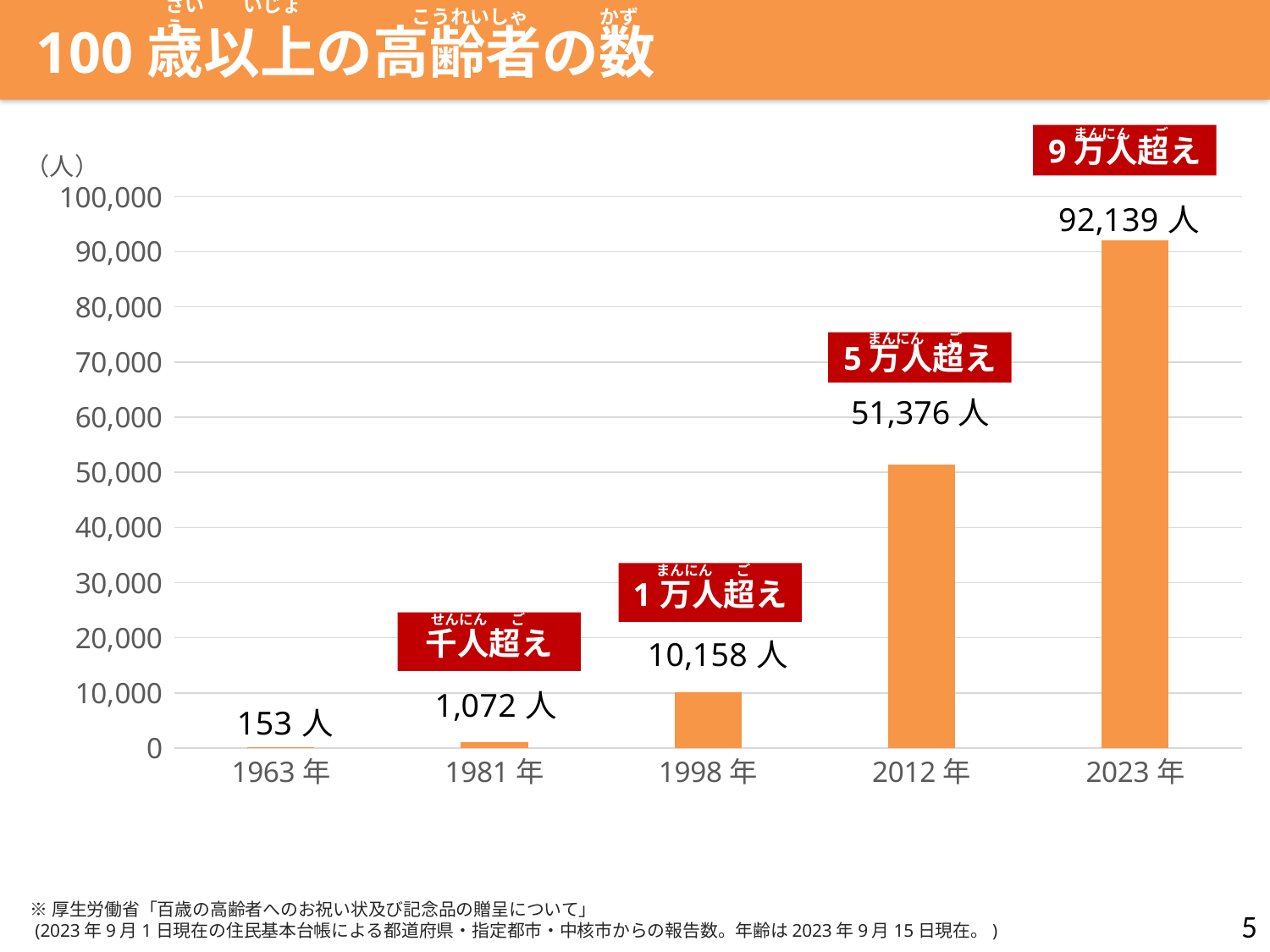
Do the values rise or fall from 1963年 to 2023年? rise What is the difference between the values for 2023年 and 2012年? 40,763 人 Which is larger, the value for 1981年 or the value for 1998年? 1998年 Is the value for 2012年 greater or less than 50,000? greater Which year has the lowest value? 1963年 What is the value for 1963年? 153 人 What kind of chart is shown on the slide? bar chart What is the value for 1998年? 10,158 人 What is the value for 2023年? 92,139 人 Which year has the highest value? 2023年 What is the value for 2012年? 51,376 人 How many years are shown on the x axis? 5